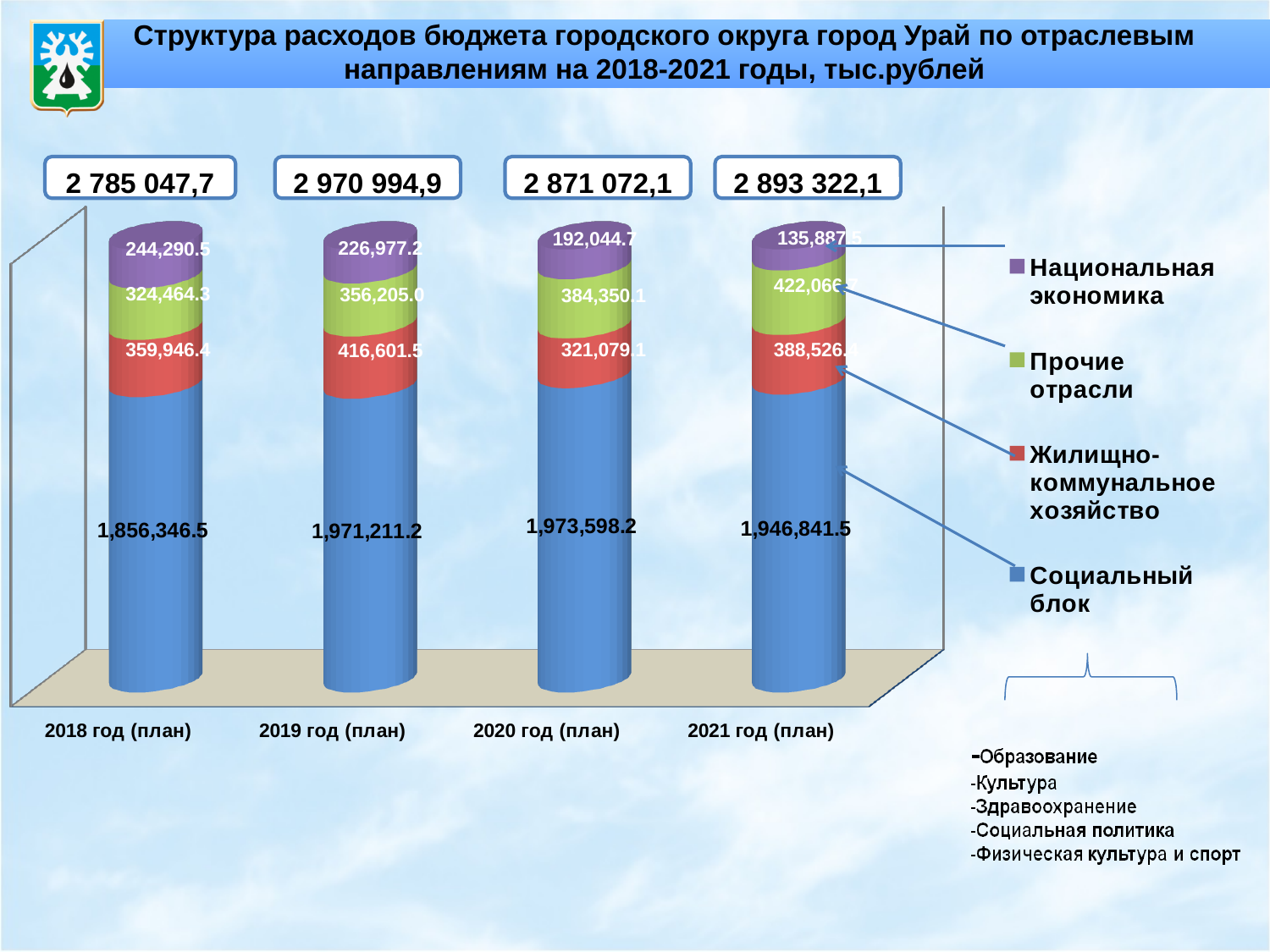
In which year is the value for Социальный блок the highest? 2020 год (план) What is the value for Национальная экономика in 2019 год (план)? 226,977.2 In which year is the value for Национальная экономика the lowest? 2021 год (план) Does the value for Национальная экономика rise or fall from 2018 to 2021? fall In 2018 год (план), which is larger: Прочие отрасли or Жилищно-коммунальное хозяйство? Жилищно-коммунальное хозяйство What is the value for Прочие отрасли in 2019 год (план)? 356,205.0 How many series does the legend list? 4 What is the difference between the Жилищно-коммунальное хозяйство values for 2019 год (план) and 2018 год (план)? 56,655.1 What is the value for Жилищно-коммунальное хозяйство in 2020 год (план)? 321,079.1 What is the value for Социальный блок in 2018 год (план)? 1,856,346.5 What is the total shown above the bar for 2019 год (план)? 2 970 994,9 What is the total shown above the bar for 2021 год (план)? 2 893 322,1